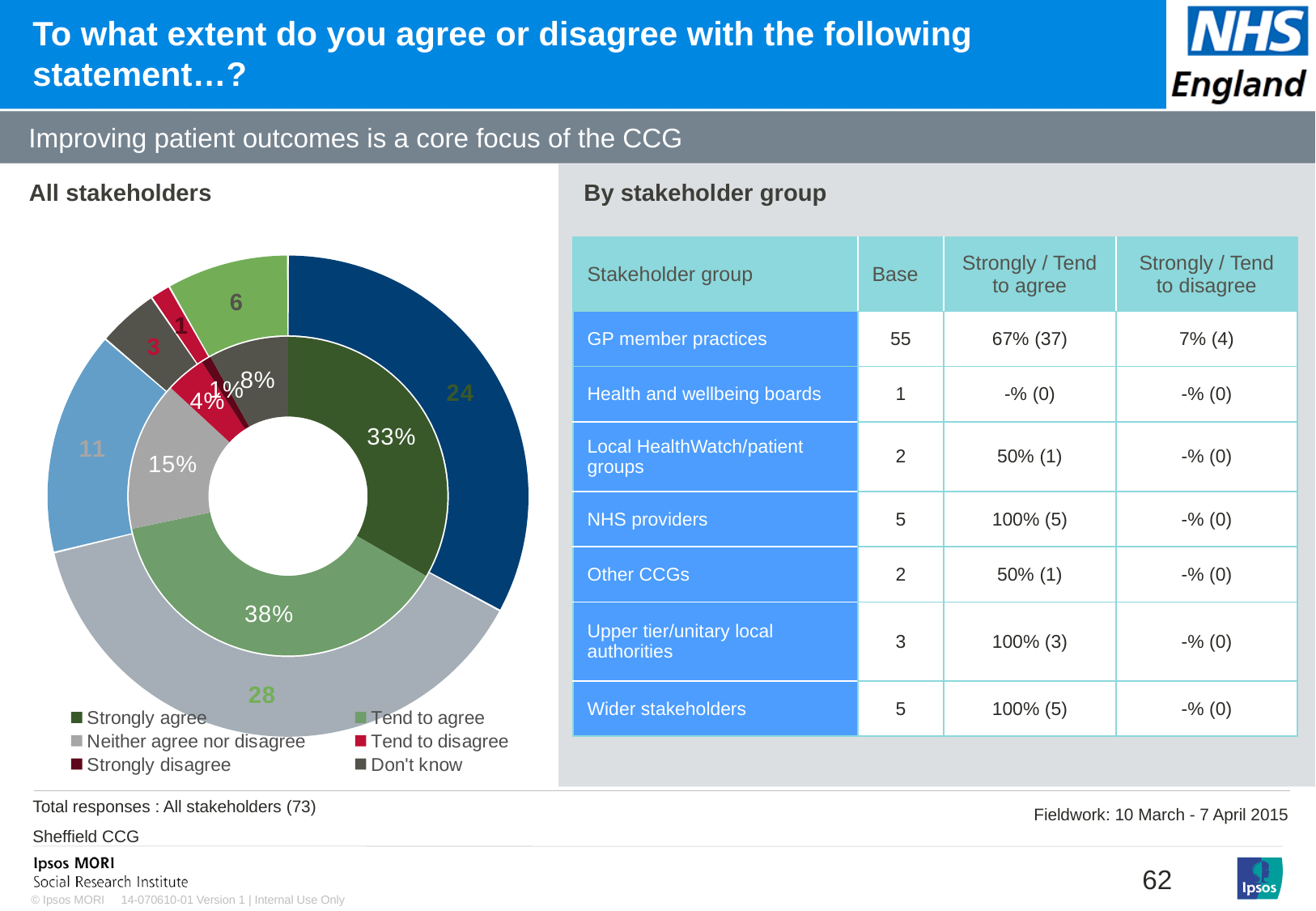
Which response category has the smallest share of all stakeholders? Strongly disagree What percentage of all stakeholders neither agree nor disagree? 15% How many response categories does the legend of the 'All stakeholders' chart list? 6 What percentage of all stakeholders strongly agree that improving patient outcomes is a core focus of the CCG? 33% Which response category has the largest share of all stakeholders? Tend to agree What is the difference in percentage points between 'Tend to agree' and 'Strongly agree' among all stakeholders? 5 What percentage of all stakeholders answered 'Don't know'? 8% What percentage of all stakeholders tend to agree? 38% What type of chart is used to show the 'All stakeholders' results? Doughnut chart What percentage of all stakeholders tend to disagree? 4% Which is larger among all stakeholders: the share who neither agree nor disagree, or the share who answered 'Don't know'? Neither agree nor disagree What colour represents 'Tend to disagree' in the 'All stakeholders' chart? Red